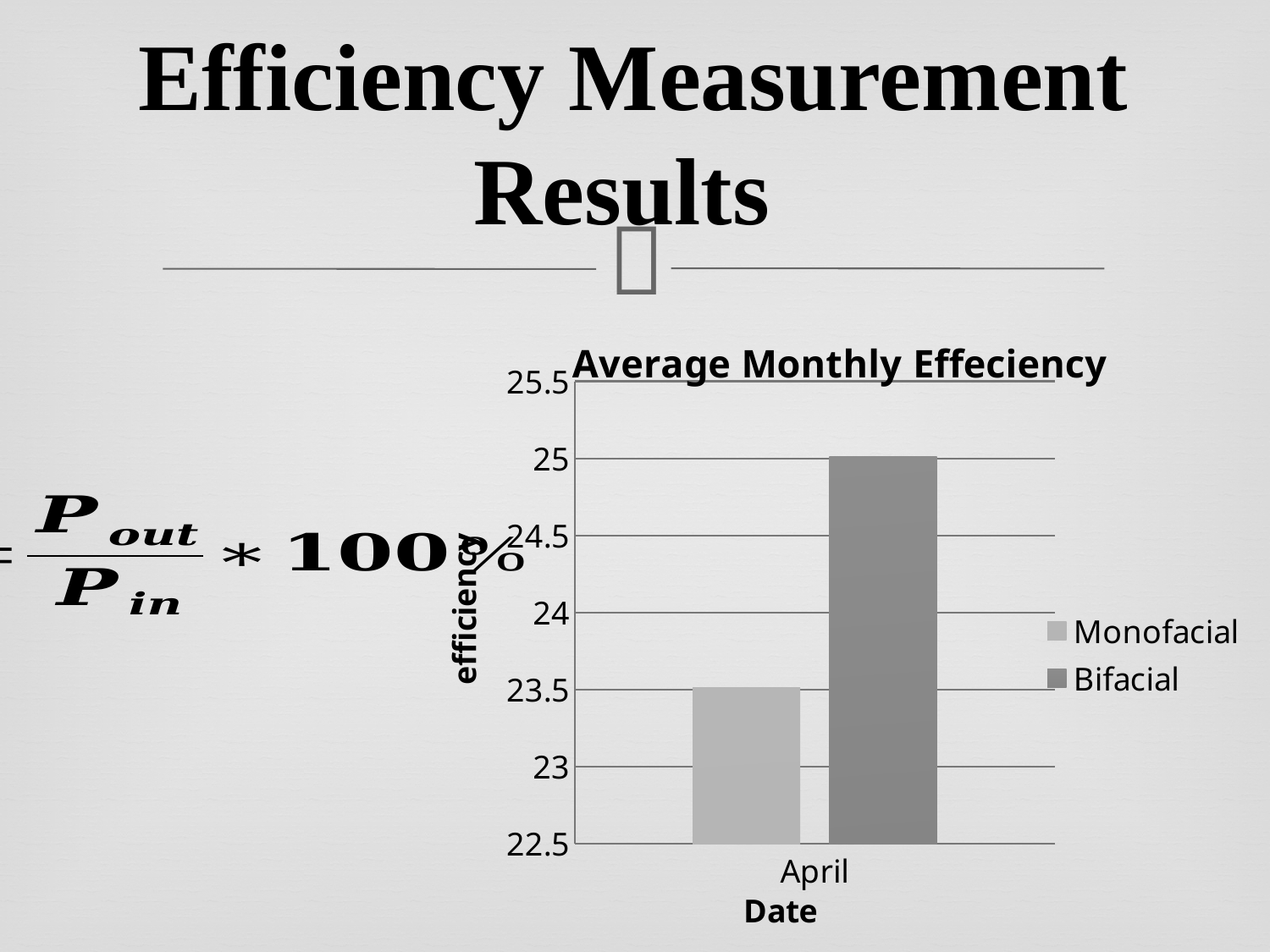
How many series does the chart's legend list? 2 Is the value for Bifacial in April greater or less than 24.5? greater How many categories are shown on the x axis of the chart? 1 Is the value for Monofacial in April greater or less than 24? less Which series has the highest value in the chart? Bifacial What kind of chart is shown on the slide? bar chart What is the title of the chart? Average Monthly Effeciency Which series has the higher value for April, Monofacial or Bifacial? Bifacial Which category is shown on the x axis of the chart? April Is the value for Bifacial in April greater or less than 25.5? less Which series has the lowest value in the chart? Monofacial